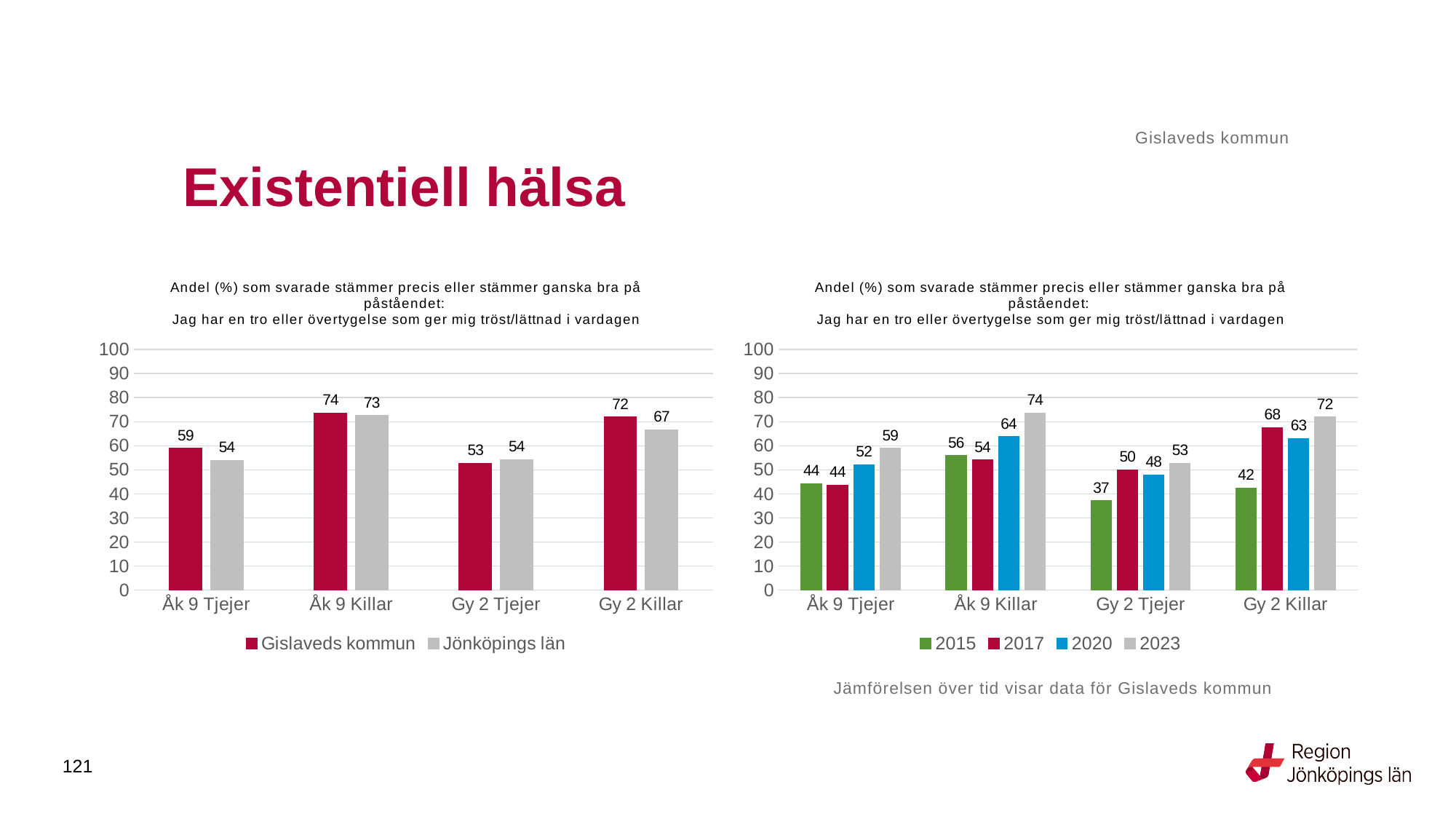
In the right chart, what is the value for 2020 for Åk 9 Killar? 64 In the right chart, how many series does the legend list? 4 In the left chart, what is the difference between Gislaveds kommun and Jönköpings län for Åk 9 Tjejer? 5 In the left chart, which is larger for Gy 2 Tjejer: Gislaveds kommun or Jönköpings län? Jönköpings län In the right chart, what is the value for 2015 for Gy 2 Tjejer? 37 In the left chart, how many series does the legend list? 2 In the right chart, what is the difference between the 2023 and 2015 values for Gy 2 Killar? 30 In the left chart, which category has the highest value for Gislaveds kommun? Åk 9 Killar In the left chart, what is the value for Jönköpings län for Gy 2 Killar? 67 In the right chart, which category has the lowest value for 2023? Gy 2 Tjejer What kind of chart is the right chart? Bar chart In the left chart, what is the value for Gislaveds kommun for Åk 9 Tjejer? 59